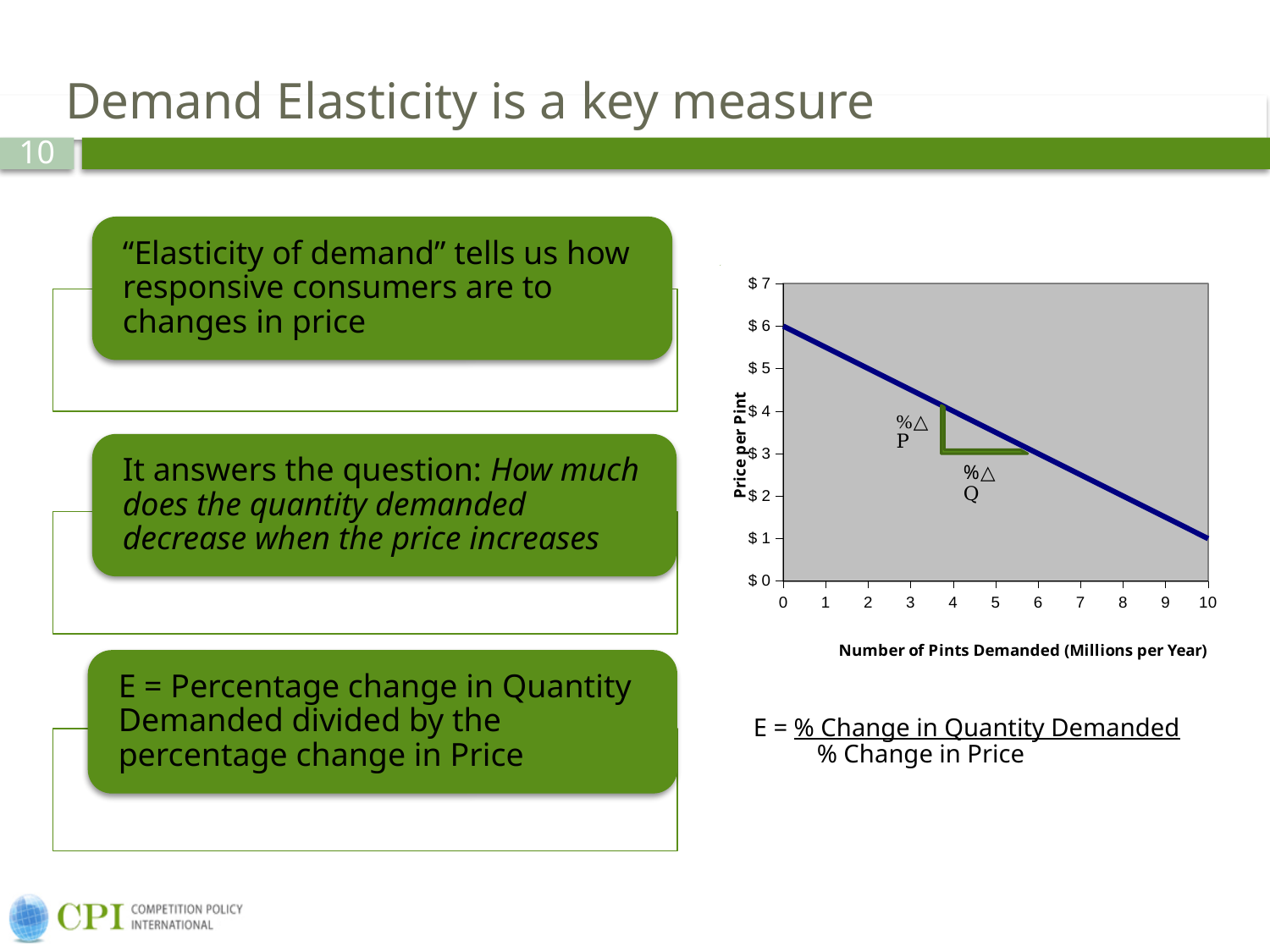
What is the price per pint when the number of pints demanded is 0? $6 What kind of chart is shown on the slide? line chart What is the difference between the price per pint at 0 pints demanded and at 10 million pints demanded? $5 Which is higher: the price per pint at 0 pints demanded or at 10 million pints demanded? 0 pints demanded What is the price per pint when the number of pints demanded is 10 million per year? $1 Is the price per pint at 1 million pints demanded greater or less than $5? greater What is the title of the y axis of the chart? Price per Pint Is the price per pint at 9 million pints demanded greater or less than $2? less Is the price per pint at 5 million pints demanded greater or less than $3? greater What is the title of the x axis of the chart? Number of Pints Demanded (Millions per Year) Does the price per pint rise or fall as the number of pints demanded increases along the x axis? fall